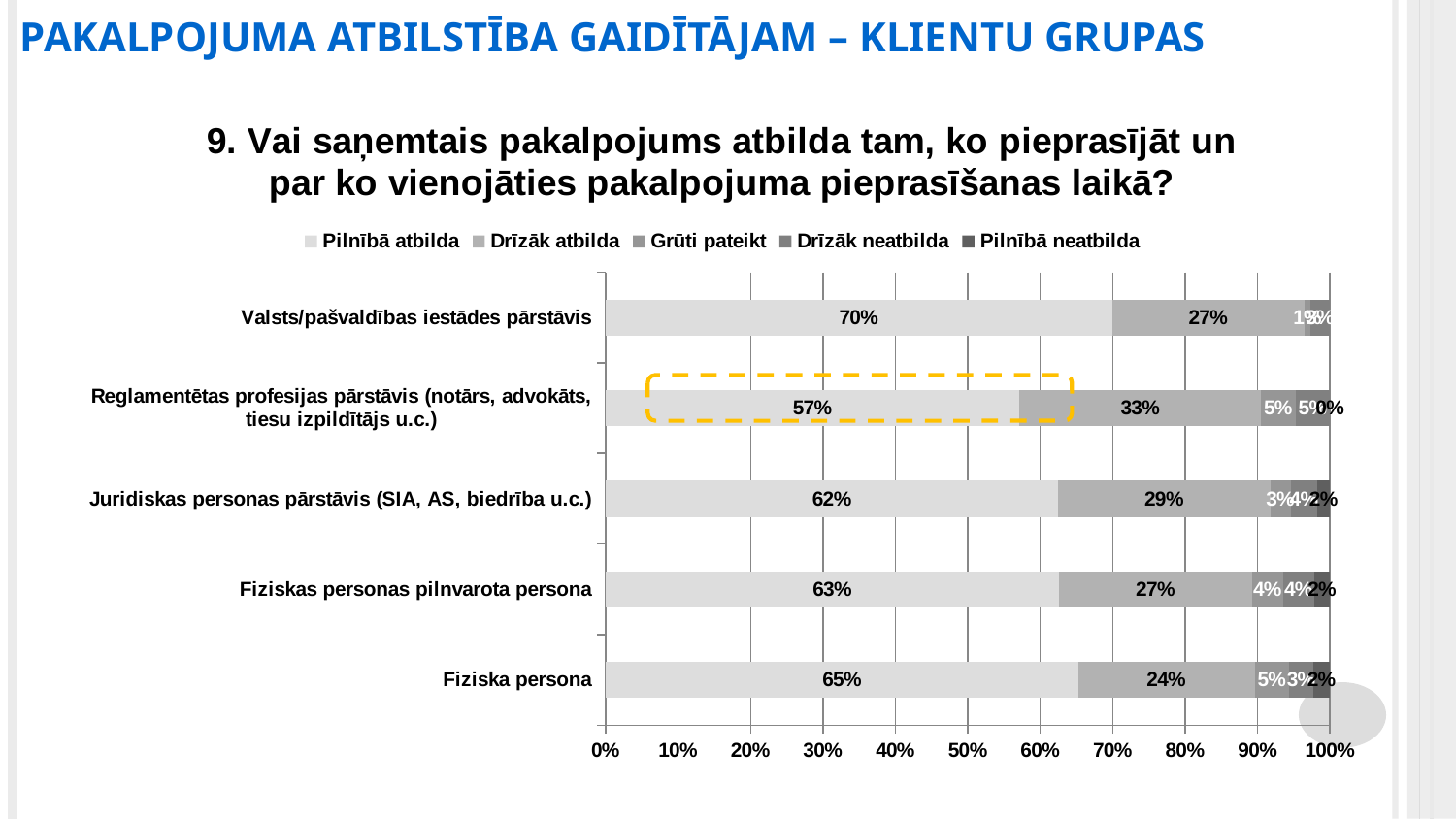
Which legend entry is listed first? Pilnībā atbilda Which client group has the lowest "Pilnībā atbilda" value? Reglamentētas profesijas pārstāvis (notārs, advokāts, tiesu izpildītājs u.c.) Which has a larger "Drīzāk atbilda" value: Reglamentētas profesijas pārstāvis or Fiziska persona? Reglamentētas profesijas pārstāvis How many client groups (categories) are shown on the chart? 5 What is the "Pilnībā atbilda" value for Valsts/pašvaldības iestādes pārstāvis? 70% What is the "Pilnībā atbilda" value for Reglamentētas profesijas pārstāvis (notārs, advokāts, tiesu izpildītājs u.c.)? 57% What is the "Drīzāk atbilda" value for Juridiskas personas pārstāvis (SIA, AS, biedrība u.c.)? 29% What is the "Drīzāk atbilda" value for Fiziska persona? 24% What type of chart is shown on the slide? Stacked bar chart What is the difference between the "Pilnībā atbilda" values for Fiziska persona and Fiziskas personas pilnvarota persona? 2% Which client group has the highest "Pilnībā atbilda" value? Valsts/pašvaldības iestādes pārstāvis How many series does the legend list? 5